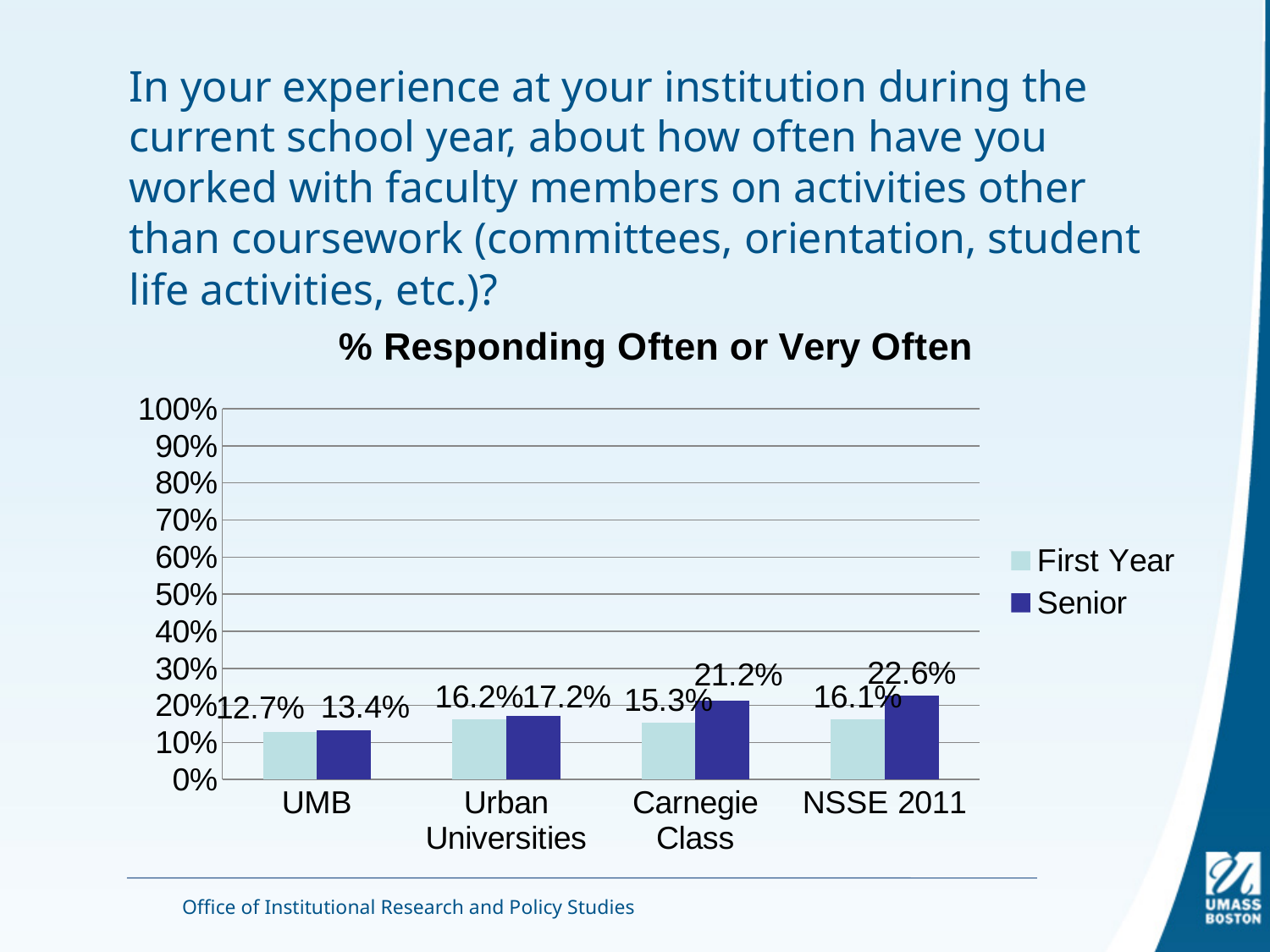
What is the Senior value for NSSE 2011? 22.6% What is the Senior value for Carnegie Class? 21.2% Which category has the highest Senior value? NSSE 2011 Which is larger for UMB, the First Year value or the Senior value? Senior Is the Senior value for NSSE 2011 greater or less than 30%? less What is the difference between the Senior and First Year values for Carnegie Class? 5.9% What is the First Year value for UMB? 12.7% How many series does the legend list? 2 What is the First Year value for Urban Universities? 16.2% Which category has the lowest First Year value? UMB How many categories are shown on the x axis? 4 What kind of chart is shown on the slide? bar chart